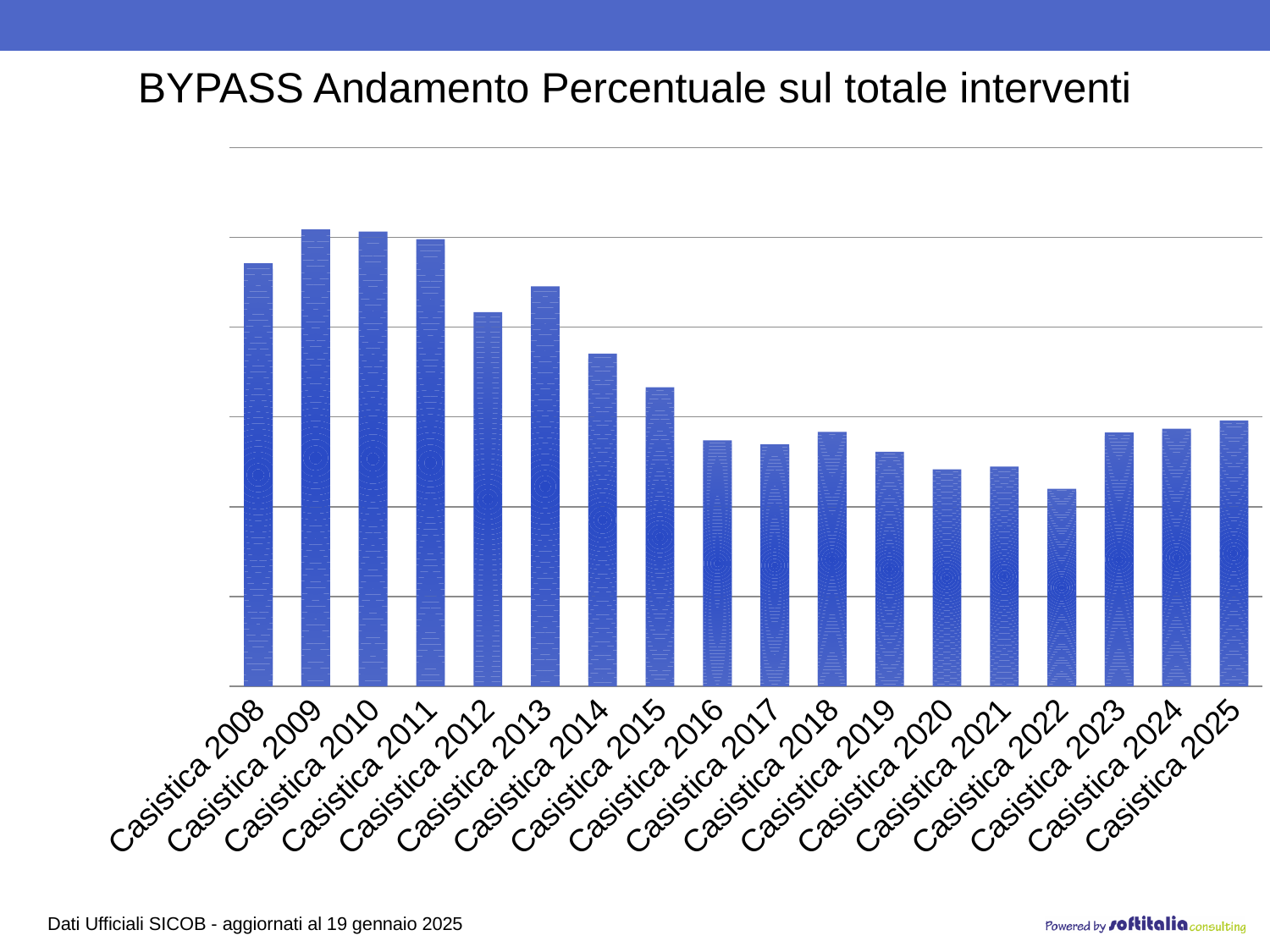
Which is larger, the value for Casistica 2015 or Casistica 2016? Casistica 2015 What kind of chart is shown on the slide? bar chart Which is larger, the value for Casistica 2013 or Casistica 2014? Casistica 2013 What is the title of the chart? BYPASS Andamento Percentuale sul totale interventi What is the first category on the x axis? Casistica 2008 Which is larger, the value for Casistica 2023 or Casistica 2025? Casistica 2025 How many categories (bars) are plotted in the chart? 18 Do the values generally rise or fall from Casistica 2011 to Casistica 2016? fall Do the values rise or fall from Casistica 2022 to Casistica 2025? rise Which category has the lowest value in the chart? Casistica 2022